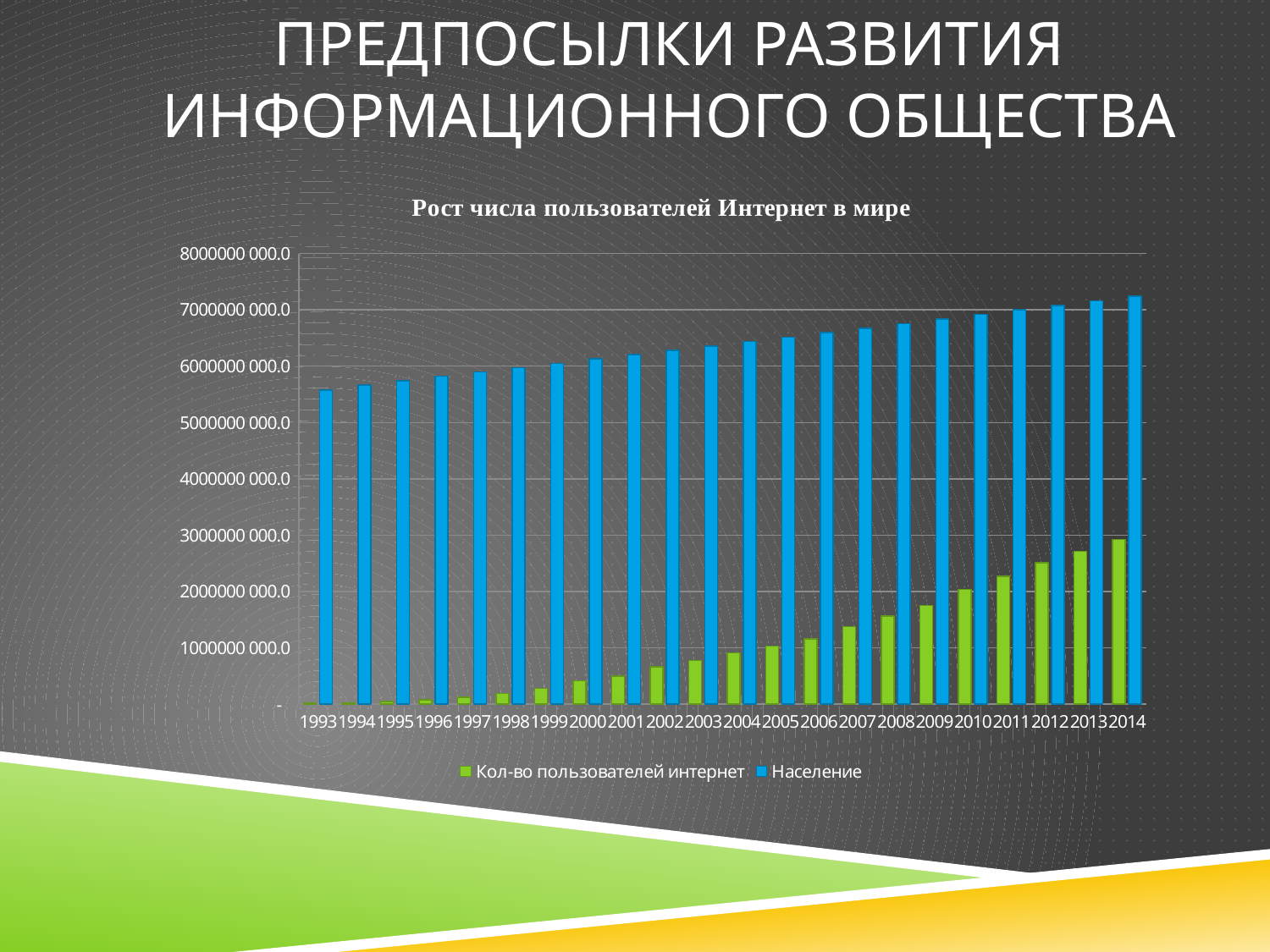
Is the value for Население in 2014 greater or less than 7000000 000.0? greater Which series is shown in green? Кол-во пользователей интернет In 2014, which is larger: Население or Кол-во пользователей интернет? Население How many years are shown on the x axis? 22 In which year is the value for Кол-во пользователей интернет highest? 2014 How many series does the legend list? 2 Do the values for Кол-во пользователей интернет rise or fall from 1993 to 2014? rise What kind of chart is shown on the slide? bar chart In which year is the value for Население highest? 2014 What is the title of the chart? Рост числа пользователей Интернет в мире In which year is the value for Кол-во пользователей интернет lowest? 1993